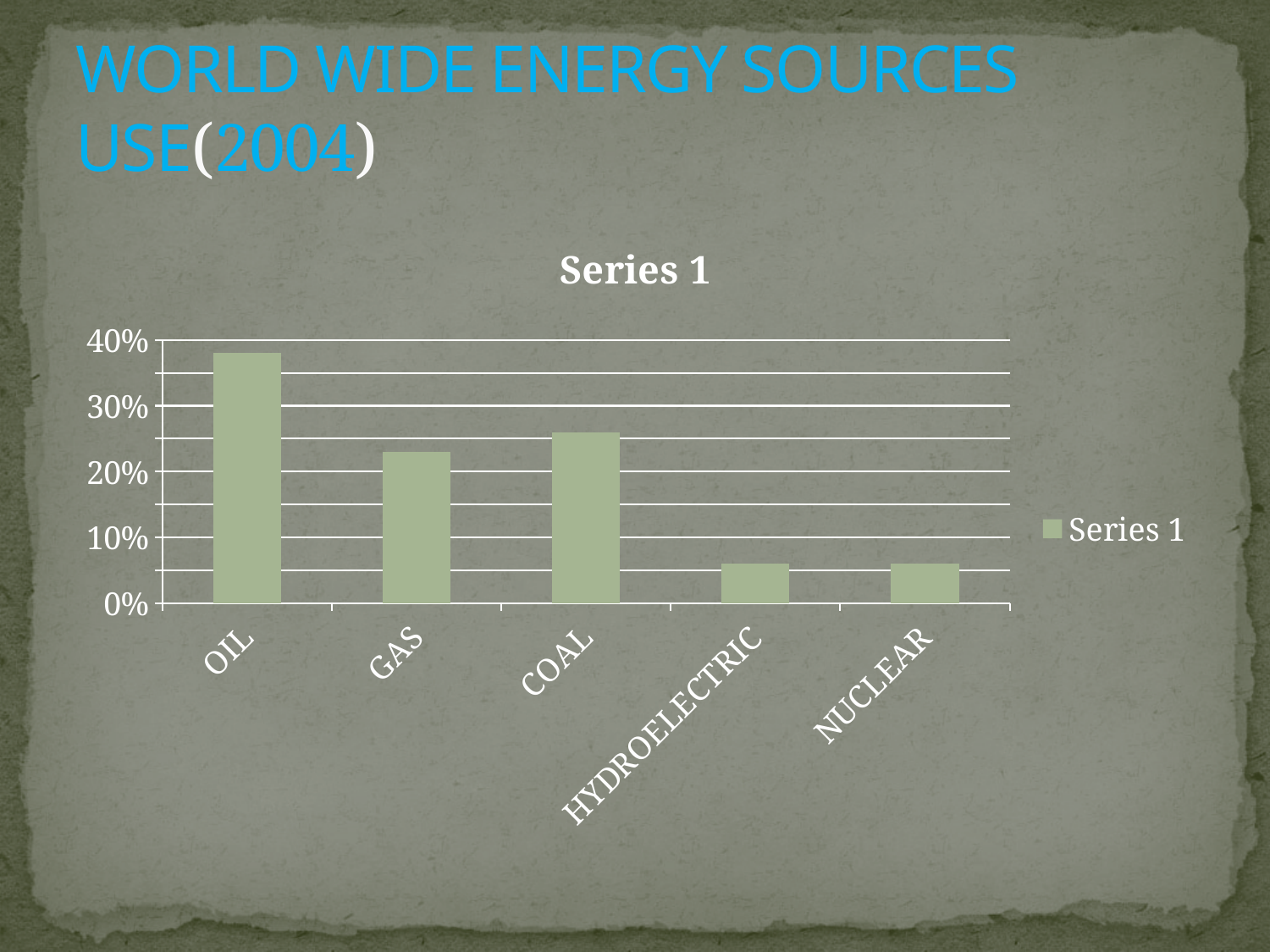
What is the title shown above the chart? Series 1 Which energy source has the highest value? OIL Which is larger, the value for COAL or the value for GAS? COAL Is the value for OIL greater or less than 30%? greater What kind of chart is shown on the slide? bar chart Is the value for HYDROELECTRIC greater or less than 10%? less Which is larger, the value for OIL or the value for GAS? OIL Is the value for NUCLEAR greater or less than 10%? less How many series does the legend list? 1 How many energy source categories are shown on the x axis? 5